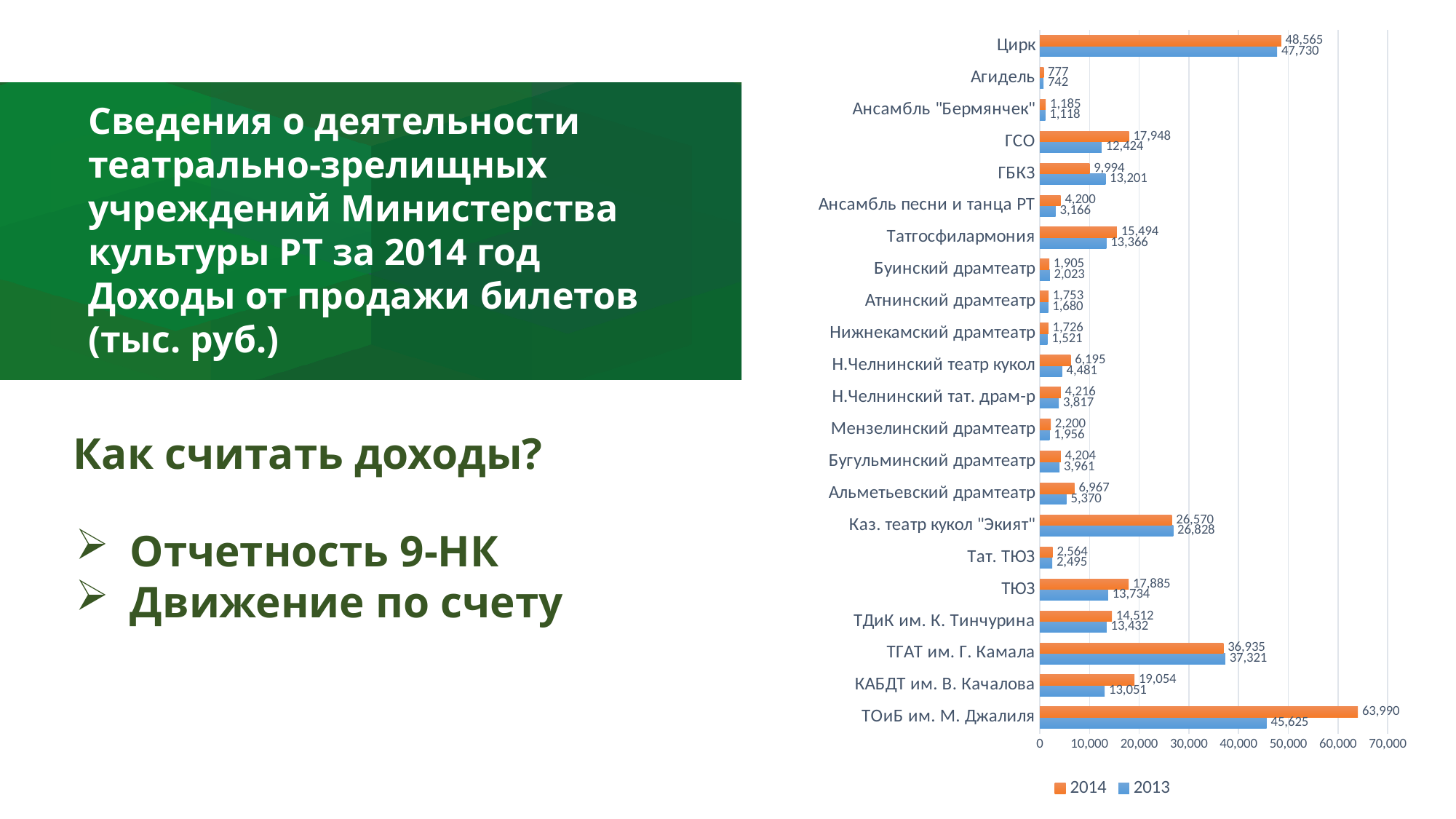
For ГБКЗ, which year has the larger value, 2014 or 2013? 2013 What is the 2014 value for Татгосфилармония? 15,494 Which institution has the highest 2014 value? ТОиБ им. М. Джалиля Which institution has the lowest 2014 value? Агидель Which series is shown in orange in the legend? 2014 What is the difference between the 2014 and 2013 values for ТОиБ им. М. Джалиля? 18,365 What is the difference between the 2014 and 2013 values for ГСО? 5,524 What type of chart is shown on the slide? bar chart What is the 2013 value for Цирк? 47,730 How many series does the legend list? 2 How many institutions (categories) are shown in the chart? 22 What is the 2014 value for ТОиБ им. М. Джалиля? 63,990